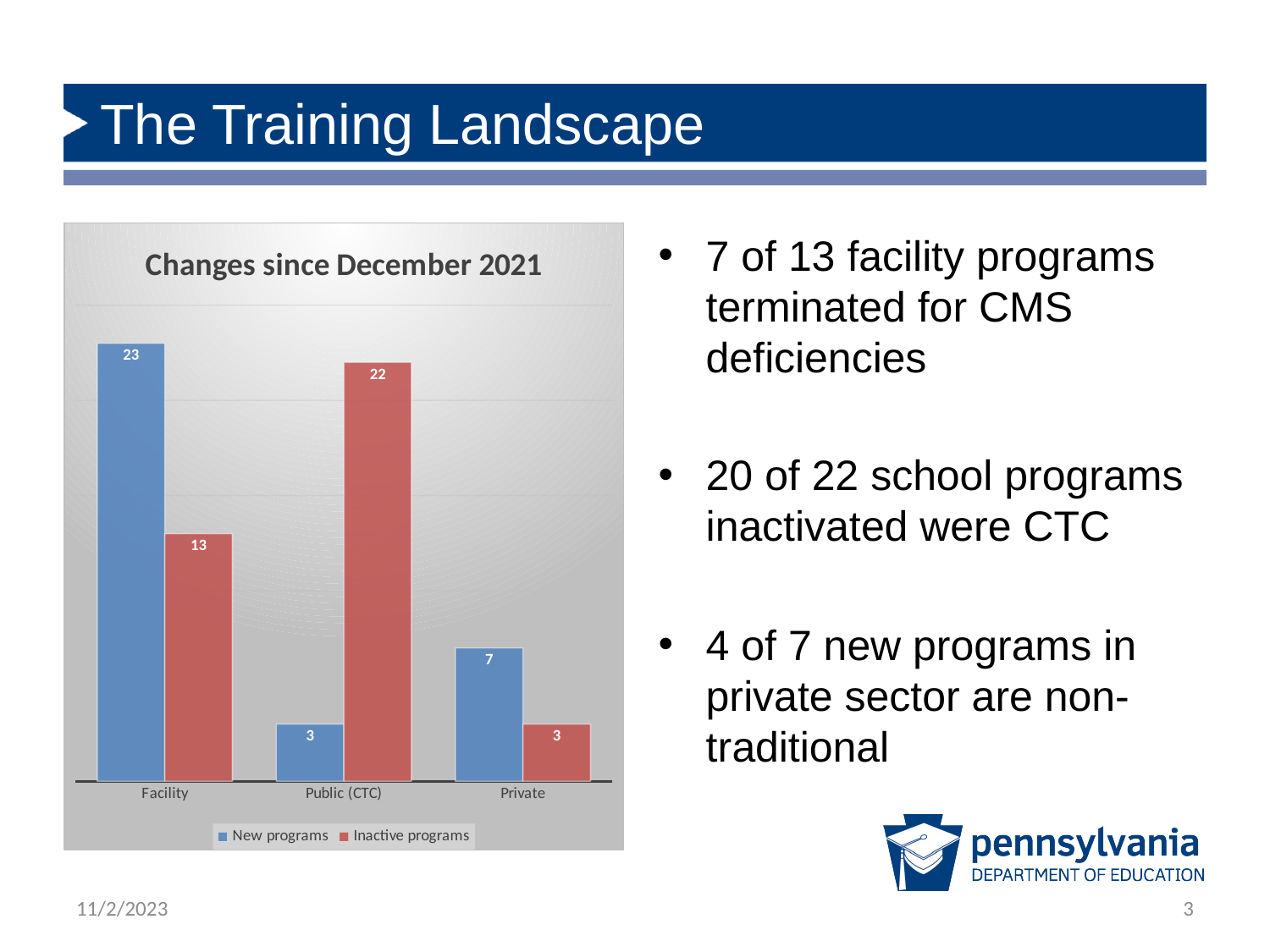
What is the value for New programs in the Facility category? 23 What is the value for New programs in the Private category? 7 Which category has the lowest value for Inactive programs? Private What is the difference between Inactive programs and New programs in the Public (CTC) category? 19 How many series does the legend list? 2 Which is larger in the Private category, New programs or Inactive programs? New programs What is the title of the chart? Changes since December 2021 Which category has the highest value for New programs? Facility How many categories are shown on the x axis? 3 What is the difference between New programs and Inactive programs in the Facility category? 10 What is the value for Inactive programs in the Public (CTC) category? 22 What kind of chart is shown on the slide? Bar chart